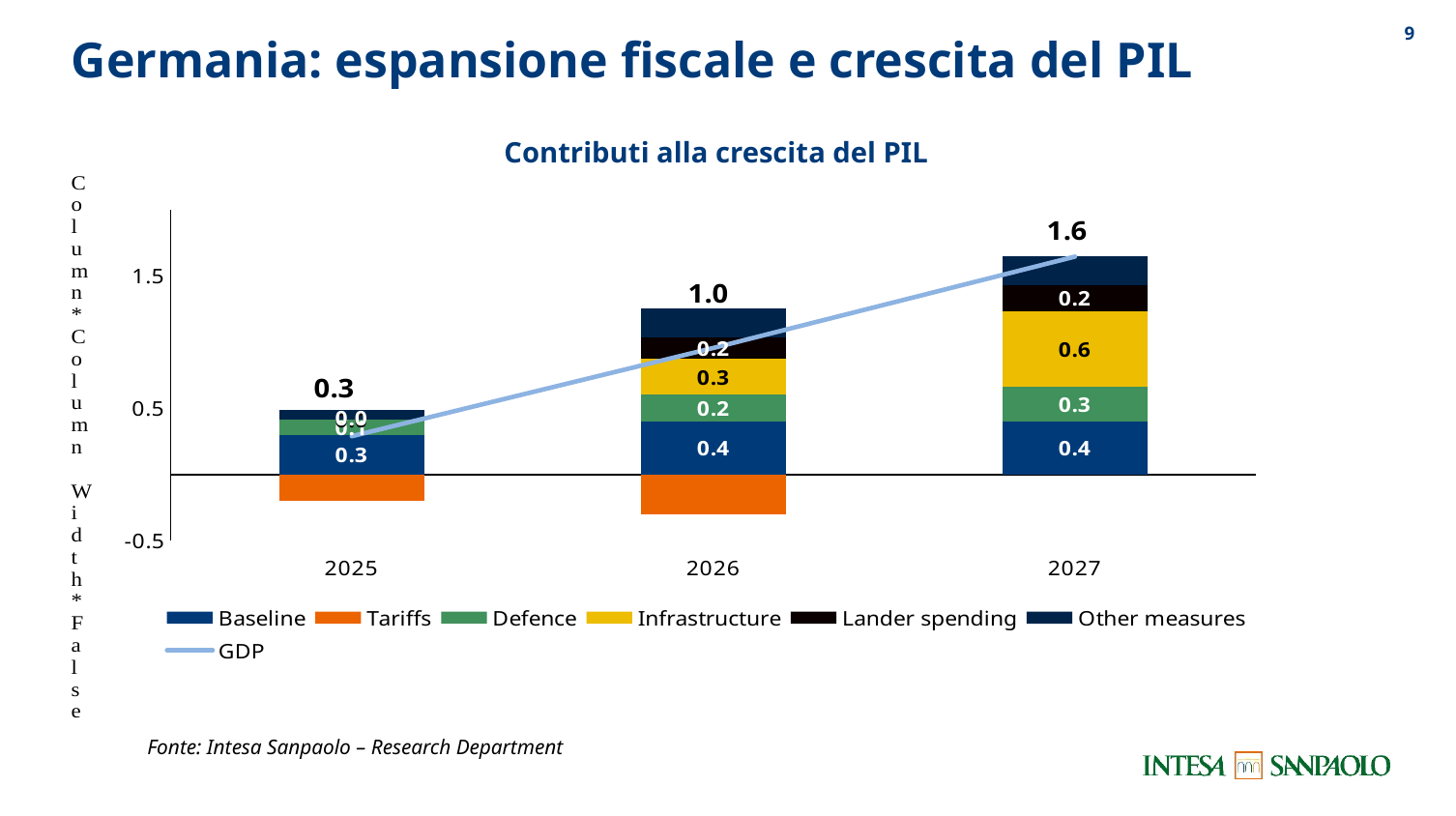
What is the title of the chart? Contributi alla crescita del PIL What kind of chart is shown on the slide? combination bar and line chart In which year is the GDP value highest? 2027 Is the Tariffs value for 2026 greater or less than -0.5? greater What is the Baseline value for 2026? 0.4 How many series does the legend list? 7 Does the GDP line rise or fall from 2025 to 2027? rise What is the GDP value for 2027? 1.6 What is the Infrastructure value for 2027? 0.6 What is the Lander spending value for 2026? 0.2 How many years are shown on the x axis of the chart? 3 What is the difference between the GDP value for 2027 and the GDP value for 2026? 0.6